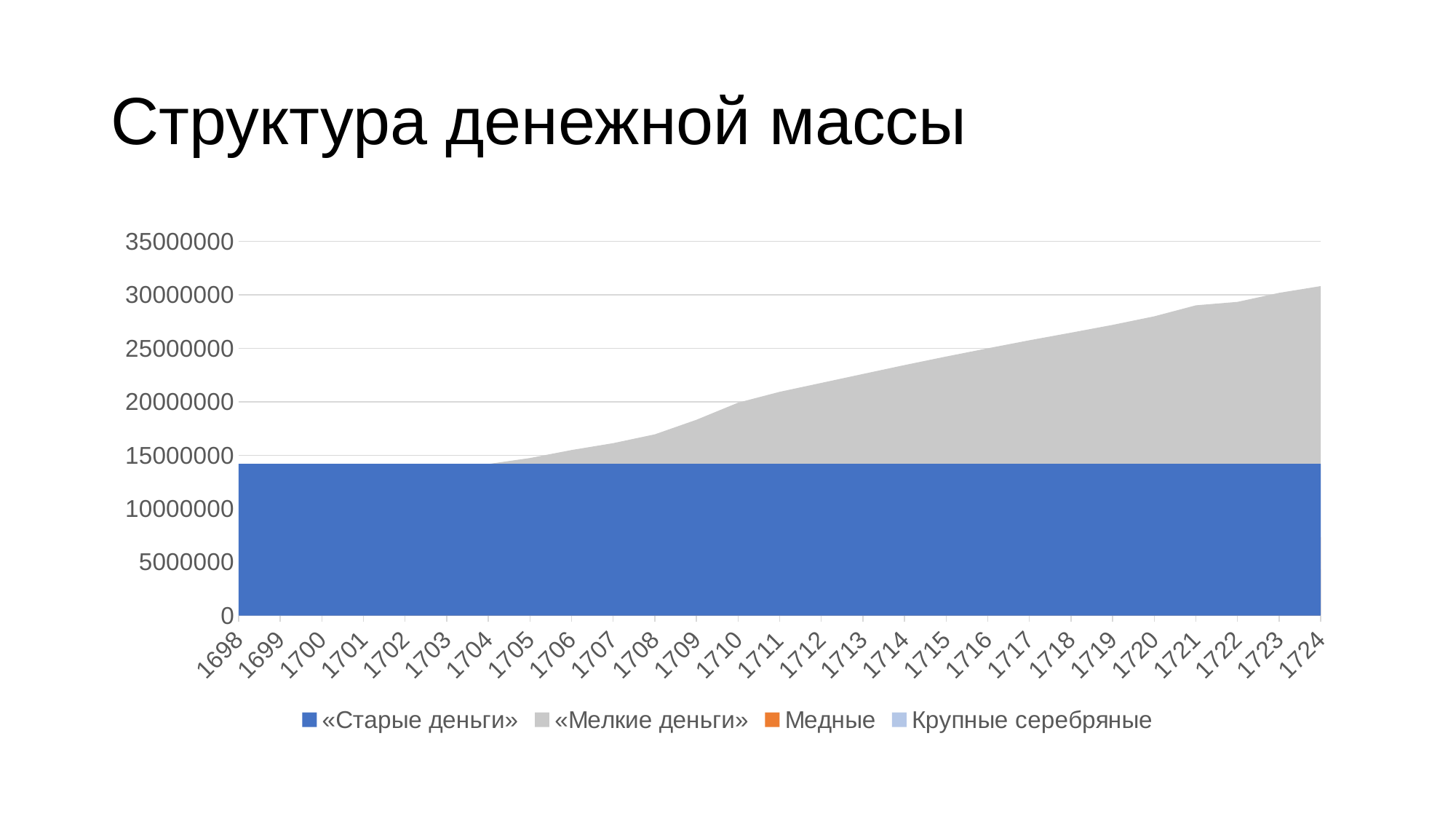
What kind of chart is shown on the slide? Area chart Is the total value for 1724 greater or less than 25000000? greater Is the total value for 1698 greater or less than 15000000? less Which series is shown in blue? «Старые деньги» Which year has the larger total value, 1698 or 1724? 1724 What is the title of the chart? Структура денежной массы Is the total value for 1715 greater or less than 20000000? greater How many series does the legend list? 4 How many years are shown along the x axis? 27 Does the total money supply rise or fall from 1698 to 1724? Rises Which year has the highest total value? 1724